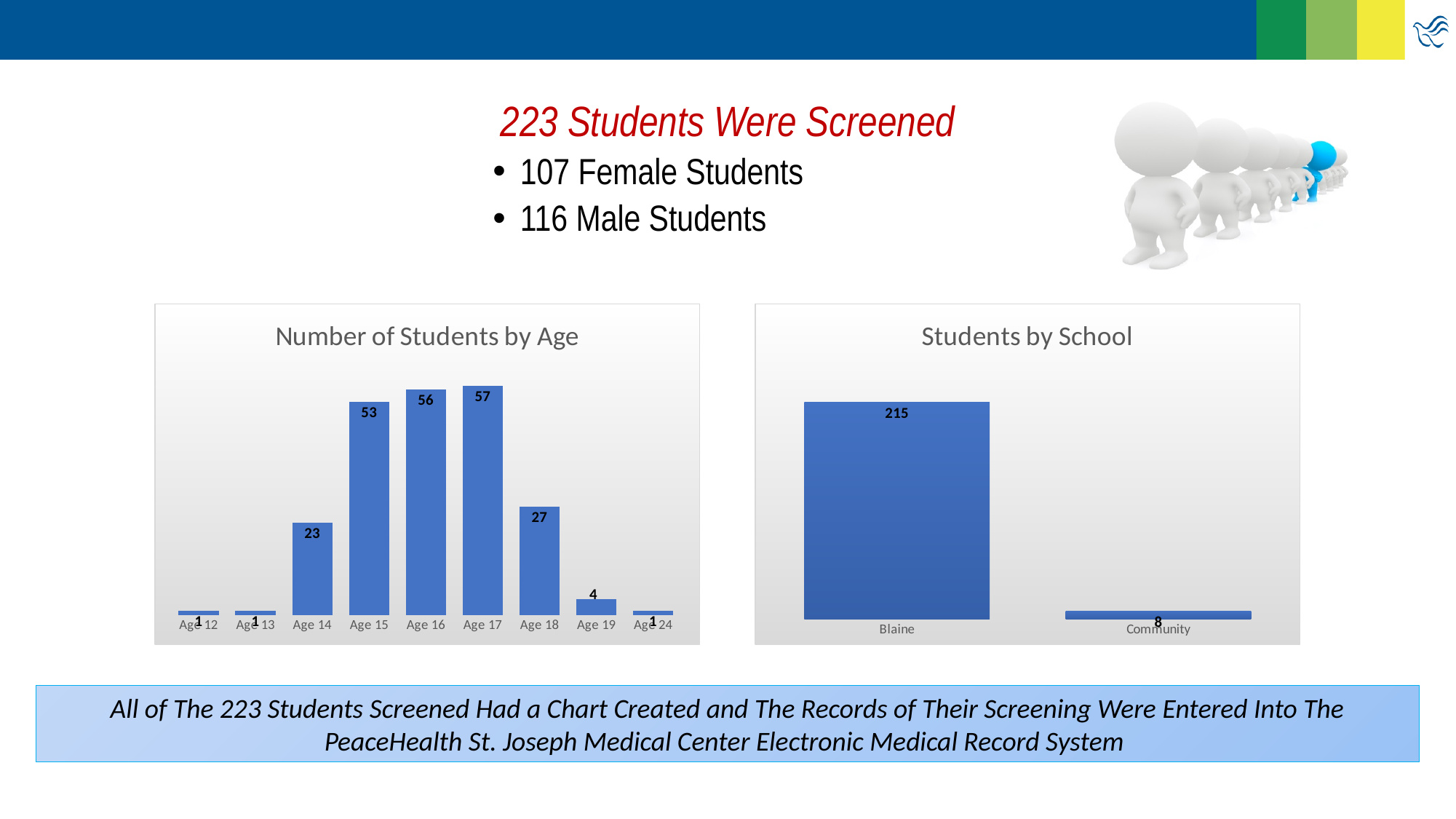
In the 'Students by School' chart, how many students are from Community? 8 In the 'Students by School' chart, what is the difference between the Blaine and Community values? 207 In the 'Number of Students by Age' chart, how many students are Age 17? 57 What type of chart is 'Students by School'? Bar chart In the 'Number of Students by Age' chart, how many students are Age 19? 4 In the 'Number of Students by Age' chart, which has more students, Age 15 or Age 18? Age 15 In the 'Number of Students by Age' chart, how many age categories are shown? 9 In the 'Students by School' chart, how many students are from Blaine? 215 In the 'Number of Students by Age' chart, which age has the most students? Age 17 In the 'Number of Students by Age' chart, how many students are Age 14? 23 What is the title of the chart on the left side of the slide? Number of Students by Age In the 'Number of Students by Age' chart, what is the difference between the number of students at Age 16 and Age 18? 29